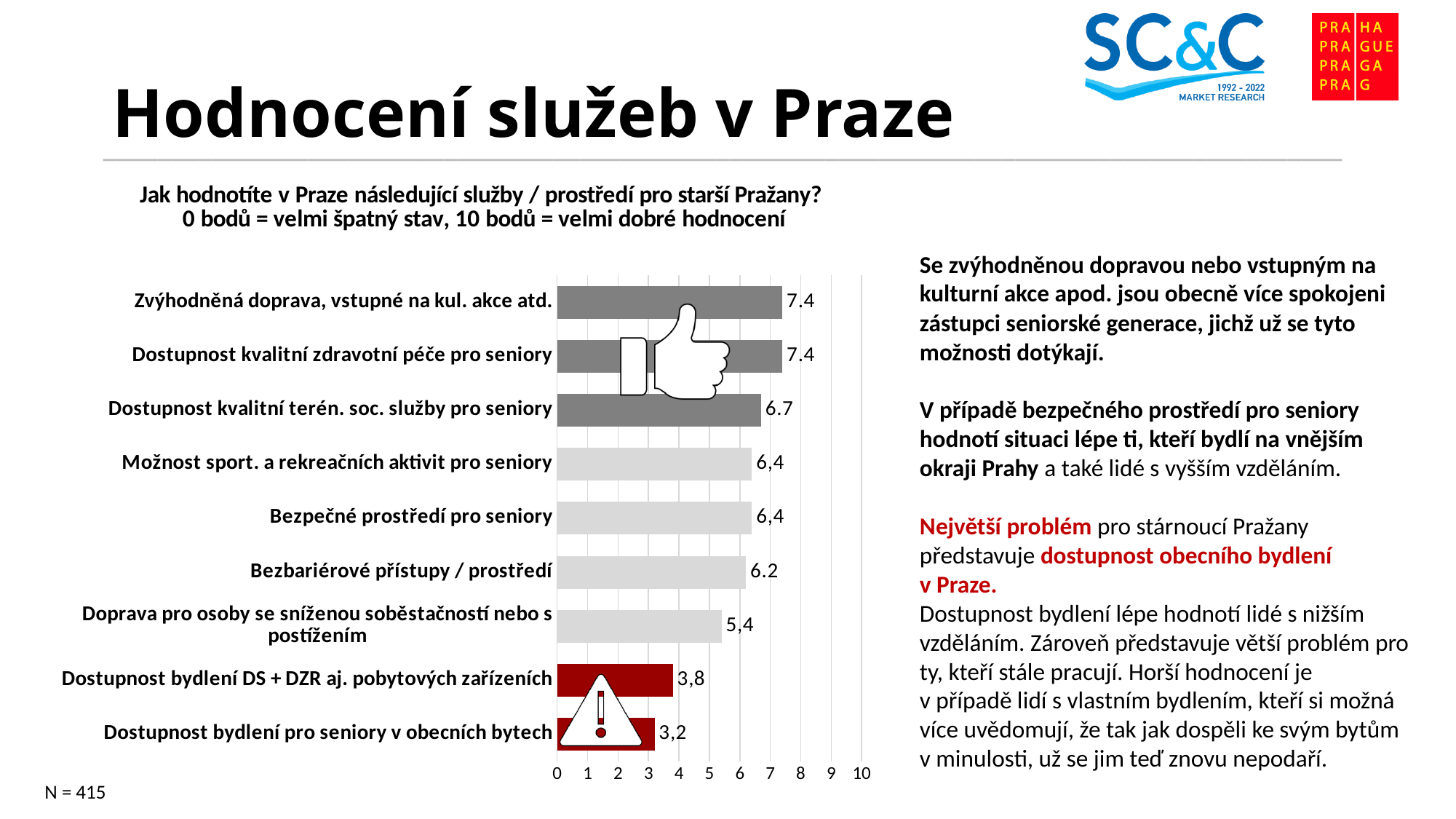
What is the difference between the values for "Zvýhodněná doprava, vstupné na kul. akce atd." and "Dostupnost bydlení pro seniory v obecních bytech"? 4.2 Is the value for "Doprava pro osoby se sníženou soběstačností nebo s postižením" greater or less than 6? less Which is larger: the value for "Dostupnost kvalitní terén. soc. služby pro seniory" or for "Bezbariérové přístupy / prostředí"? Dostupnost kvalitní terén. soc. služby pro seniory What is the value for "Bezbariérové přístupy / prostředí"? 6.2 What is the maximum value shown on the chart's axis? 10 How many categories are shown in the chart? 9 Which category has the lowest value? Dostupnost bydlení pro seniory v obecních bytech What is the value for "Doprava pro osoby se sníženou soběstačností nebo s postižením"? 5,4 What is the value for "Dostupnost bydlení pro seniory v obecních bytech"? 3,2 What is the value for "Dostupnost kvalitní terén. soc. služby pro seniory"? 6.7 What is the difference between the values for "Dostupnost bydlení DS + DZR aj. pobytových zařízeních" and "Dostupnost bydlení pro seniory v obecních bytech"? 0,6 What kind of chart is shown on the slide? bar chart